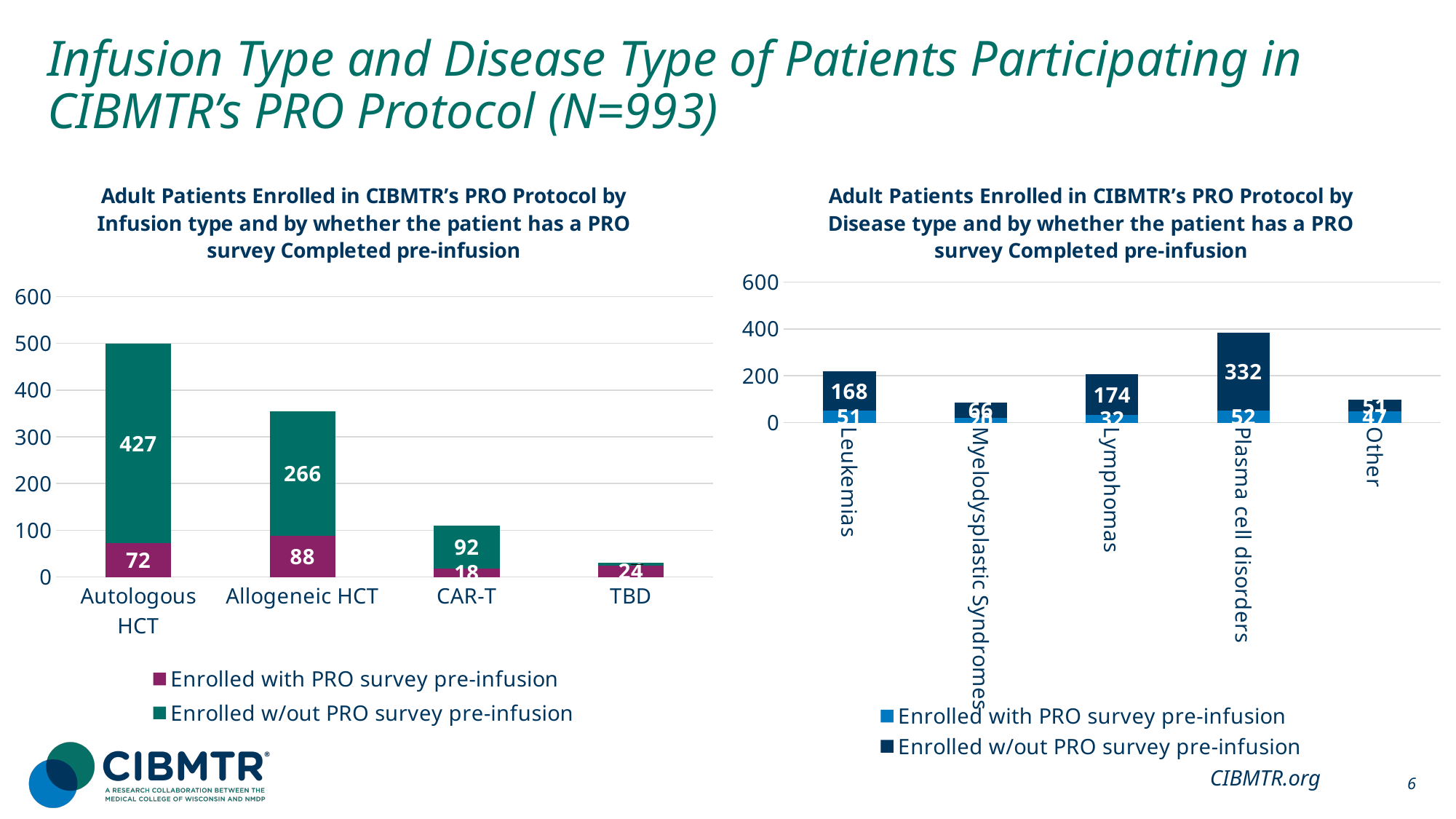
In the left chart (by Infusion type), which infusion type has the tallest stacked bar? Autologous HCT In the right chart (by Disease type), which disease type has the tallest stacked bar? Plasma cell disorders What kind of chart is the left chart (by Infusion type)? Stacked bar chart In the right chart (by Disease type), how many Plasma cell disorders patients were enrolled without a PRO survey pre-infusion? 332 In the right chart (by Disease type), what is the total number of Leukemias patients enrolled (both series combined)? 219 In the left chart (by Infusion type), what is the total number of Autologous HCT patients enrolled (both series combined)? 499 How many series does the legend of the right chart (by Disease type) list? 2 In the right chart (by Disease type), what is the difference between the number of Plasma cell disorders patients and Leukemias patients enrolled without a PRO survey pre-infusion? 164 In the right chart (by Disease type), how many Lymphomas patients were enrolled with a PRO survey pre-infusion? 32 In the left chart (by Infusion type), how many Autologous HCT patients were enrolled without a PRO survey pre-infusion? 427 How many infusion type categories are shown in the left chart? 4 In the left chart (by Infusion type), how many Allogeneic HCT patients were enrolled with a PRO survey pre-infusion? 88